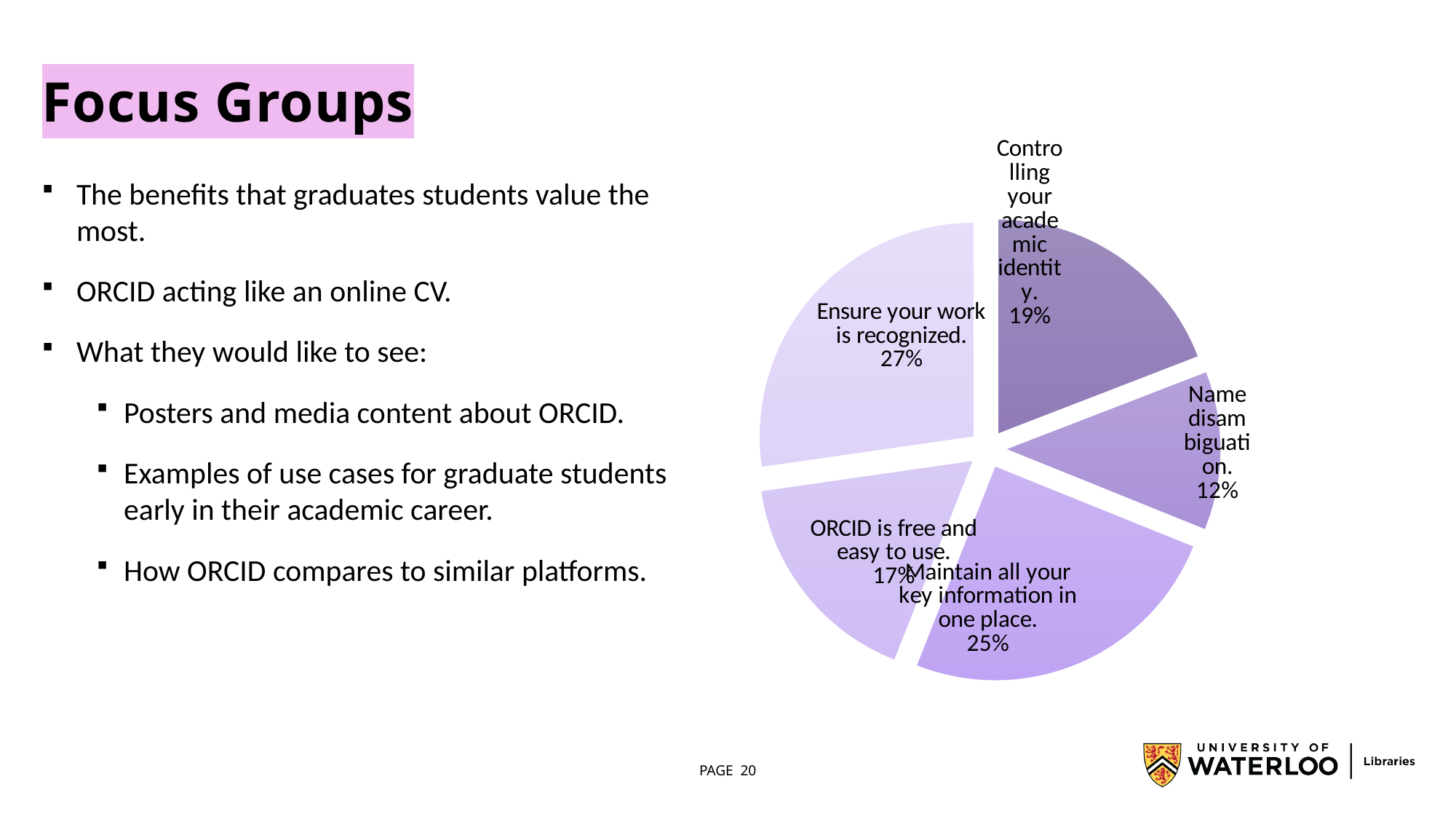
What percentage is shown for "Name disambiguation."? 12% Which slice of the pie chart is the smallest? Name disambiguation. What percentage is shown for "Maintain all your key information in one place."? 25% How many slices does the pie chart have? 5 What is the difference in percentage points between "Ensure your work is recognized." and "Name disambiguation."? 15 What share of the pie is labelled "Ensure your work is recognized."? 27% What percentage is shown for "Controlling your academic identity."? 19% Which is larger: "Controlling your academic identity." or "ORCID is free and easy to use."? Controlling your academic identity. What kind of chart is shown on the slide? Pie chart What percentage is shown for "ORCID is free and easy to use."? 17% Which slice of the pie chart is the largest? Ensure your work is recognized. What is the difference in percentage points between "Maintain all your key information in one place." and "Controlling your academic identity."? 6